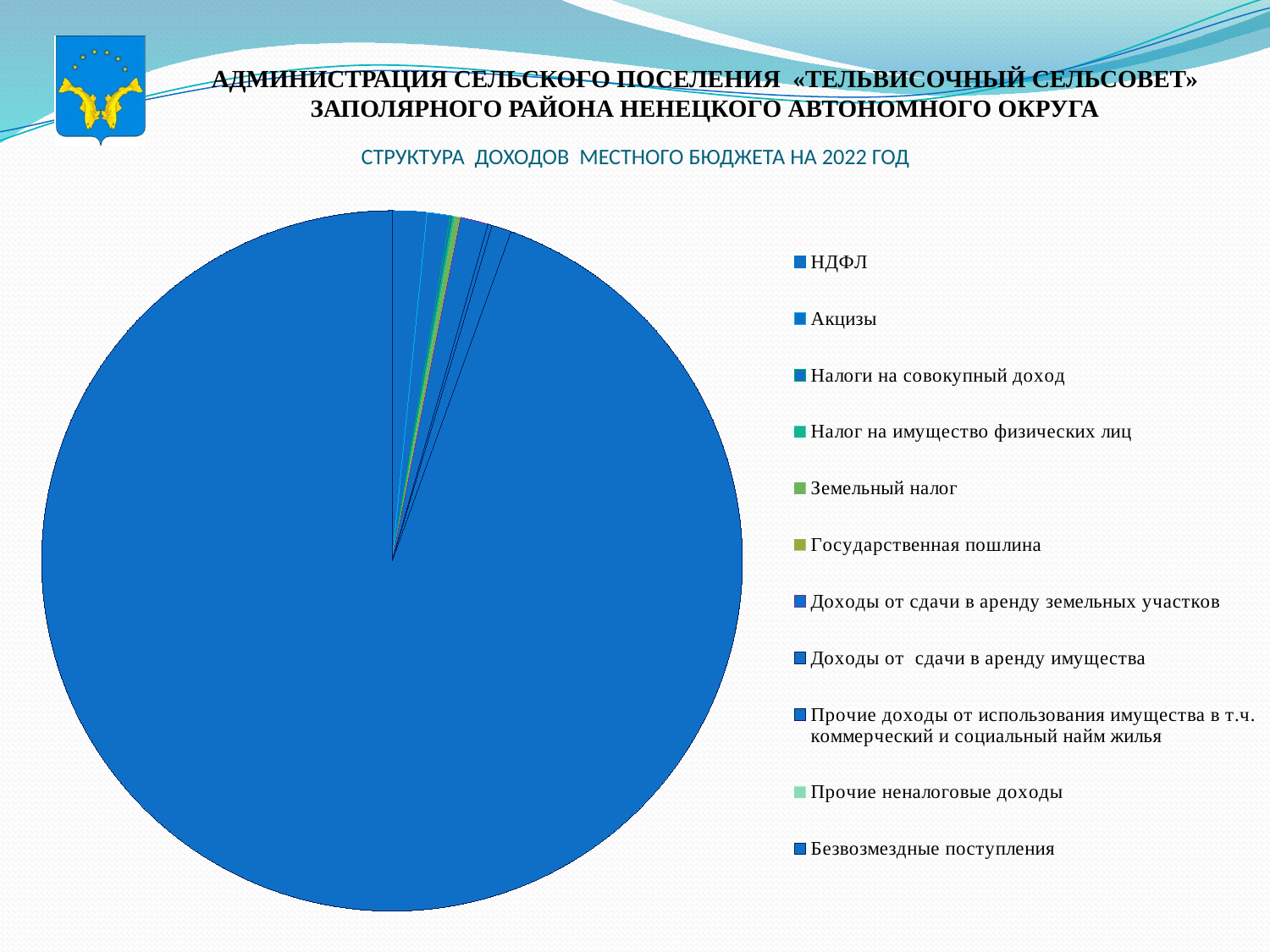
What is the title of the chart on the slide? СТРУКТУРА ДОХОДОВ МЕСТНОГО БЮДЖЕТА НА 2022 ГОД How many categories does the legend of the pie chart list? 11 Which category is listed first in the chart's legend? НДФЛ Does one slice of the pie chart account for the large majority of the whole, or are the slices roughly equal in size? one slice accounts for the large majority What kind of chart is shown on the slide? pie chart